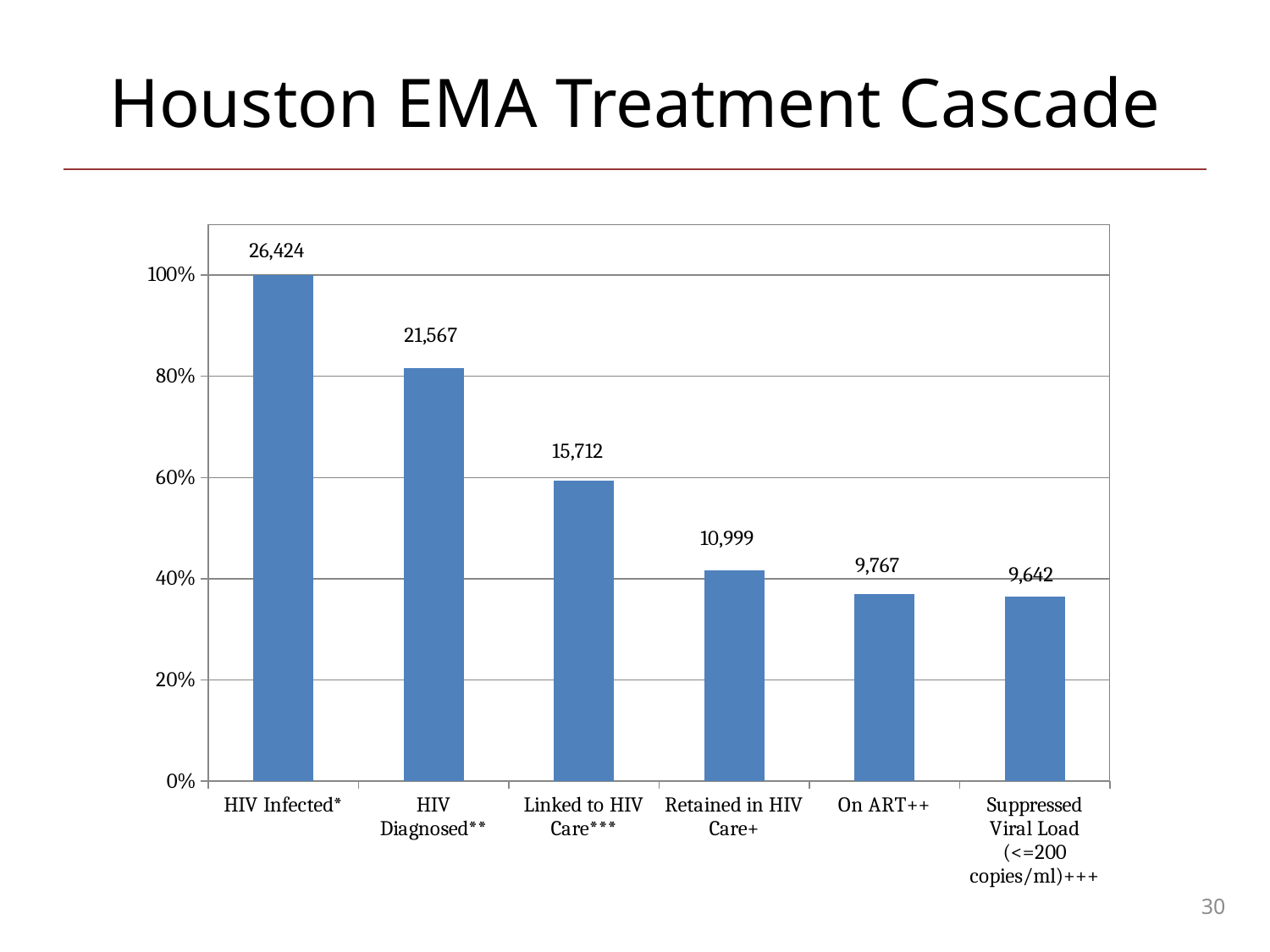
What is the difference between the HIV Infected* value and the HIV Diagnosed** value? 4,857 Is the bar for On ART++ greater or less than 40%? less What value is shown for HIV Diagnosed**? 21,567 How many categories are shown on the x axis? 6 Which category has the lowest value? Suppressed Viral Load (<=200 copies/ml)+++ What is the data label on the Retained in HIV Care+ bar? 10,999 Which category has the highest bar? HIV Infected* Which is larger, Linked to HIV Care*** or Retained in HIV Care+? Linked to HIV Care*** How much larger is the On ART++ value than the Suppressed Viral Load value? 125 What value is labelled for Suppressed Viral Load (<=200 copies/ml)+++? 9,642 What is the data label for the HIV Infected* bar? 26,424 Do the bar values rise or fall from left to right across the chart? fall